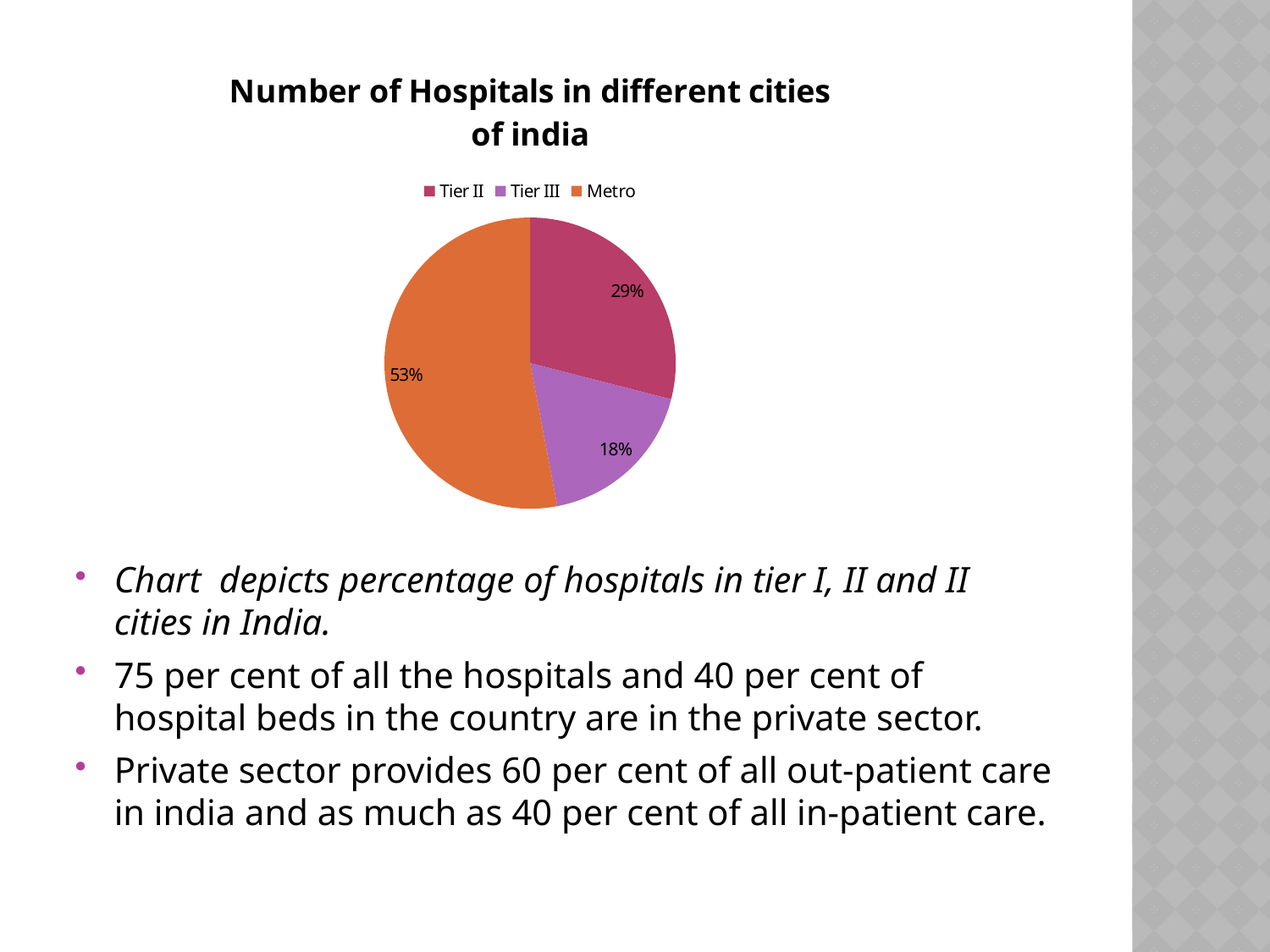
Which slice is larger, Tier II or Tier III? Tier II Which category has the largest slice of the pie? Metro What is the difference in percentage points between the Tier II and Tier III slices? 11 Which category is shown in orange in the chart? Metro What share of the pie does Tier III represent? 18% Which category has the smallest slice of the pie? Tier III What is the difference in percentage points between the Metro and Tier II slices? 24 What share of the pie does Tier II represent? 29% What is the title of the chart? Number of Hospitals in different cities of india How many categories are shown in the pie chart? 3 What kind of chart is shown on the slide? Pie chart What share of the pie does Metro represent? 53%